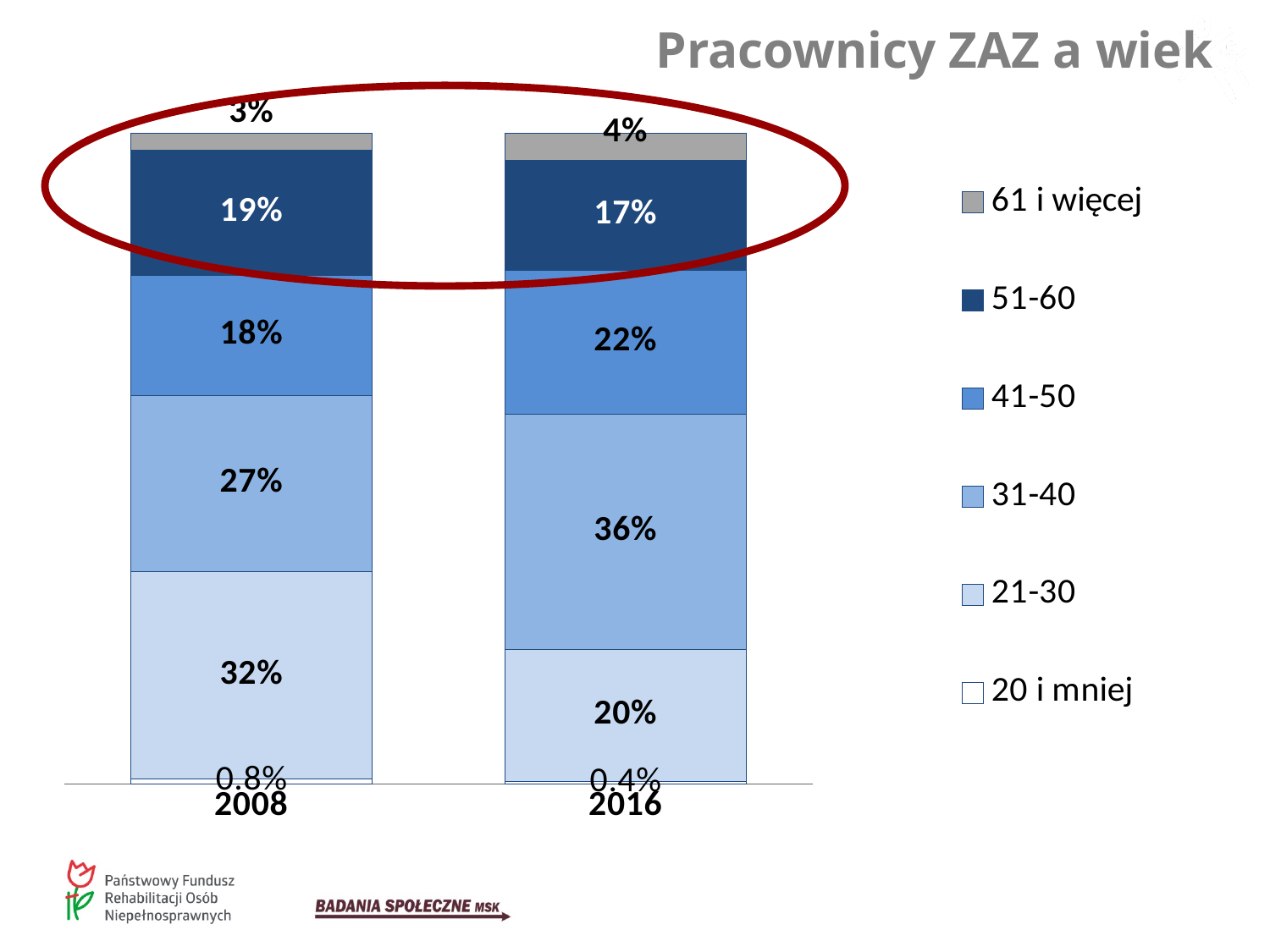
What is the title of the slide? Pracownicy ZAZ a wiek What is the value for the 20 i mniej age group in 2016? 0.4% What is the value for the 31-40 age group in 2016? 36% What is the value for the 61 i więcej age group in 2008? 3% How many bars (years) are shown in the chart? 2 Which age group has the largest share in the 2008 bar? 21-30 How many series does the legend list? 6 Which is larger: the 41-50 value in 2008 or in 2016? 2016 What is the difference between the 31-40 values for 2016 and 2008? 9% Which age group has the smallest share in the 2016 bar? 20 i mniej What is the value for the 51-60 age group in 2008? 19% What kind of chart is shown on the slide? stacked bar chart